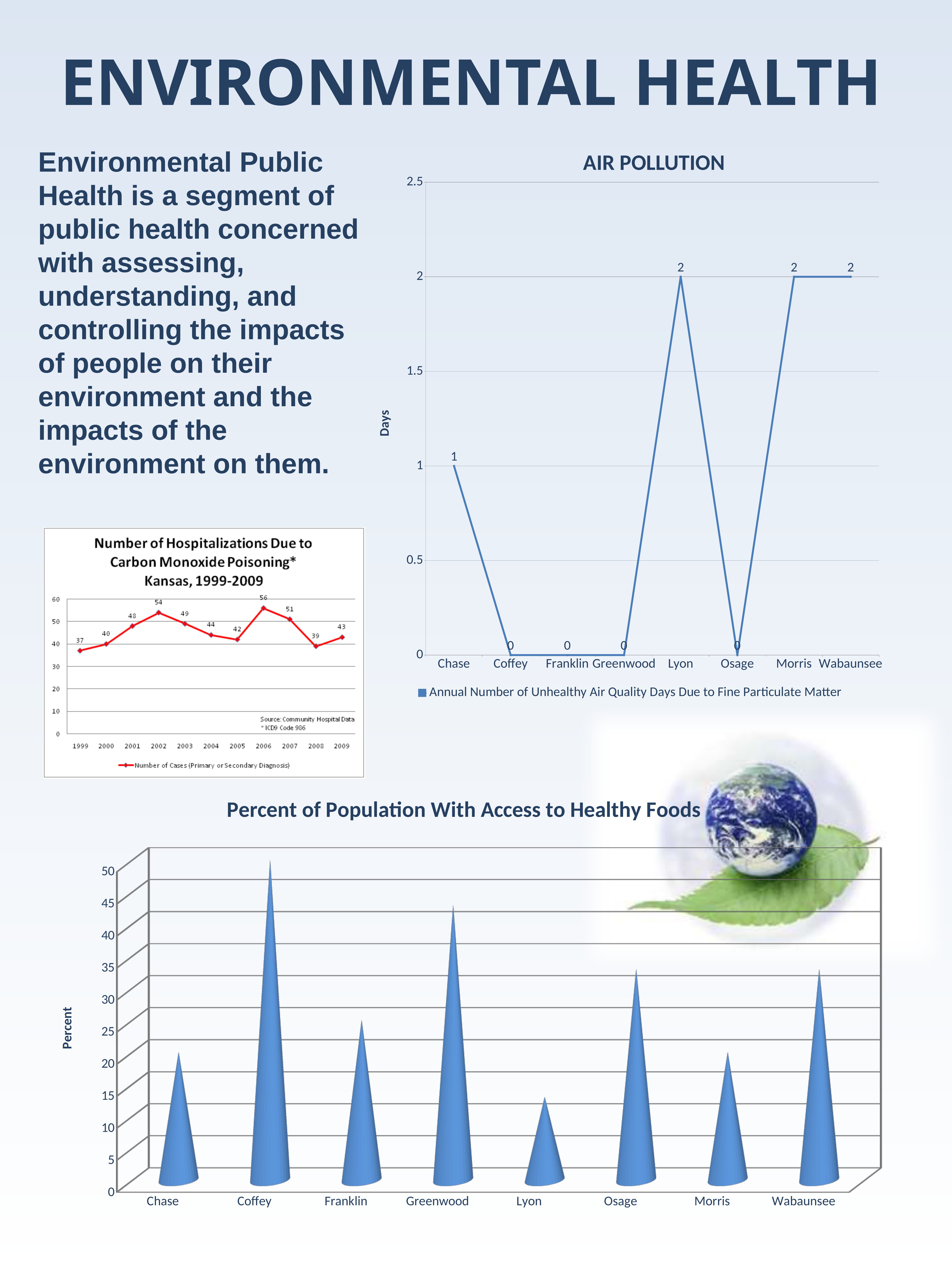
In the Percent of Population With Access to Healthy Foods chart, which county has the highest value? Coffey In the AIR POLLUTION chart, which is larger, the value for Osage or the value for Wabaunsee? Wabaunsee In the AIR POLLUTION chart, what is the value for Chase? 1 In the AIR POLLUTION chart, what is the value for Lyon? 2 In the Number of Hospitalizations Due to Carbon Monoxide Poisoning chart, what is the value for 2002? 54 In the AIR POLLUTION chart, what is the label of the y axis? Days In the Number of Hospitalizations Due to Carbon Monoxide Poisoning chart, what is the difference between the values for 2007 and 2008? 12 In the AIR POLLUTION chart, how many counties are shown on the x axis? 8 In the Percent of Population With Access to Healthy Foods chart, is the value for Lyon greater or less than 20? less In the Number of Hospitalizations Due to Carbon Monoxide Poisoning chart, which year has the highest value? 2006 In the Number of Hospitalizations Due to Carbon Monoxide Poisoning chart, which year has the lowest value? 1999 In the AIR POLLUTION chart, what is the difference between the values for Morris and Chase? 1